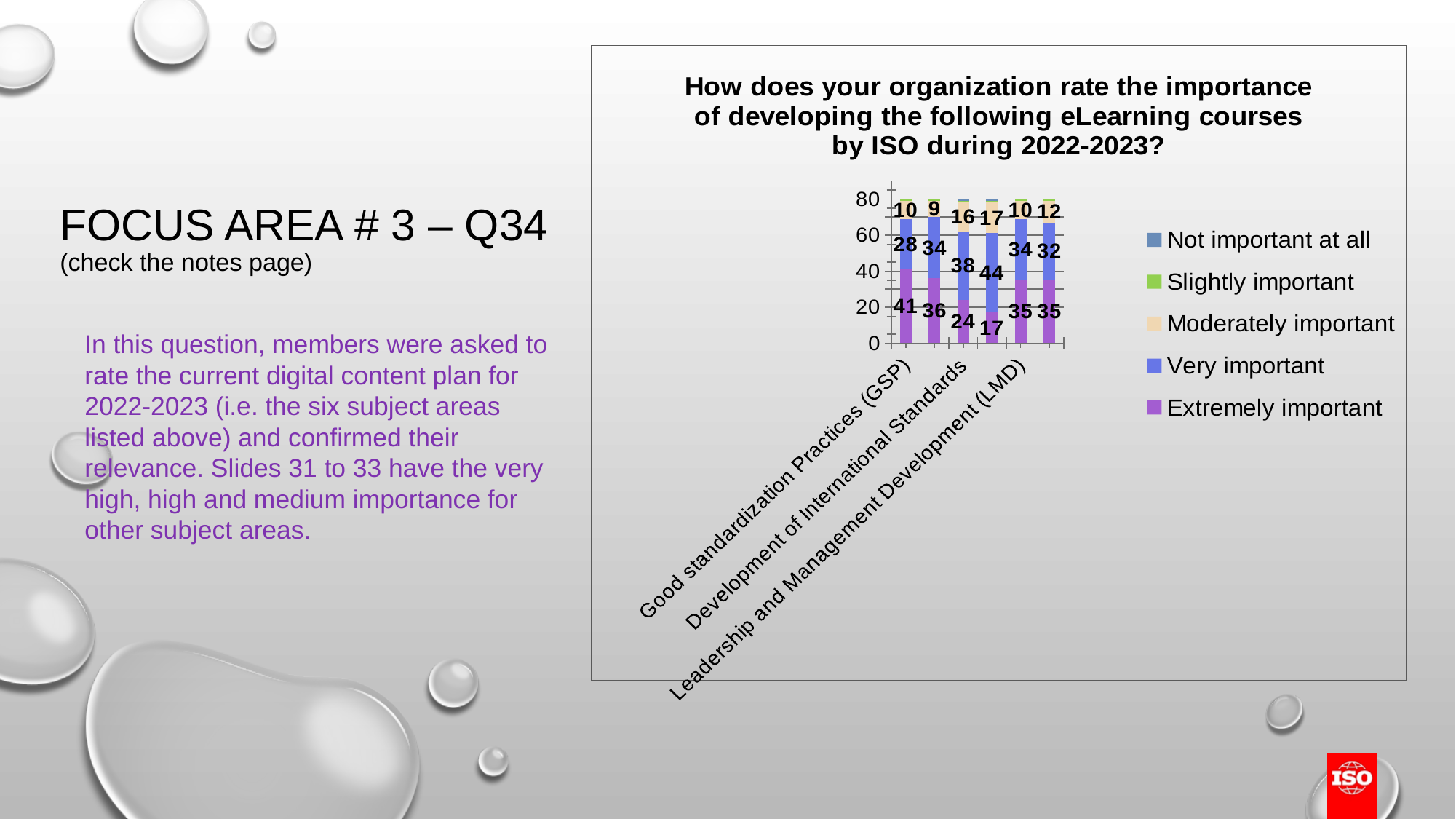
What is the lowest 'Extremely important' value labelled on any bar? 17 In the leftmost bar, what is the difference between the 'Extremely important' value and the 'Very important' value? 13 Which legend entry is shown in purple? Extremely important What is the highest 'Moderately important' value labelled on any bar? 17 What is the 'Extremely important' value for the leftmost bar? 41 How many stacked bars are plotted in the chart? 6 What is the 'Very important' value for the leftmost bar? 28 What is the title of the chart? How does your organization rate the importance of developing the following eLearning courses by ISO during 2022-2023? How many series does the chart legend list? 5 What kind of chart is shown on the slide? stacked bar chart In the leftmost bar, which is larger: the 'Extremely important' value or the 'Very important' value? Extremely important What is the highest 'Very important' value labelled on any bar? 44